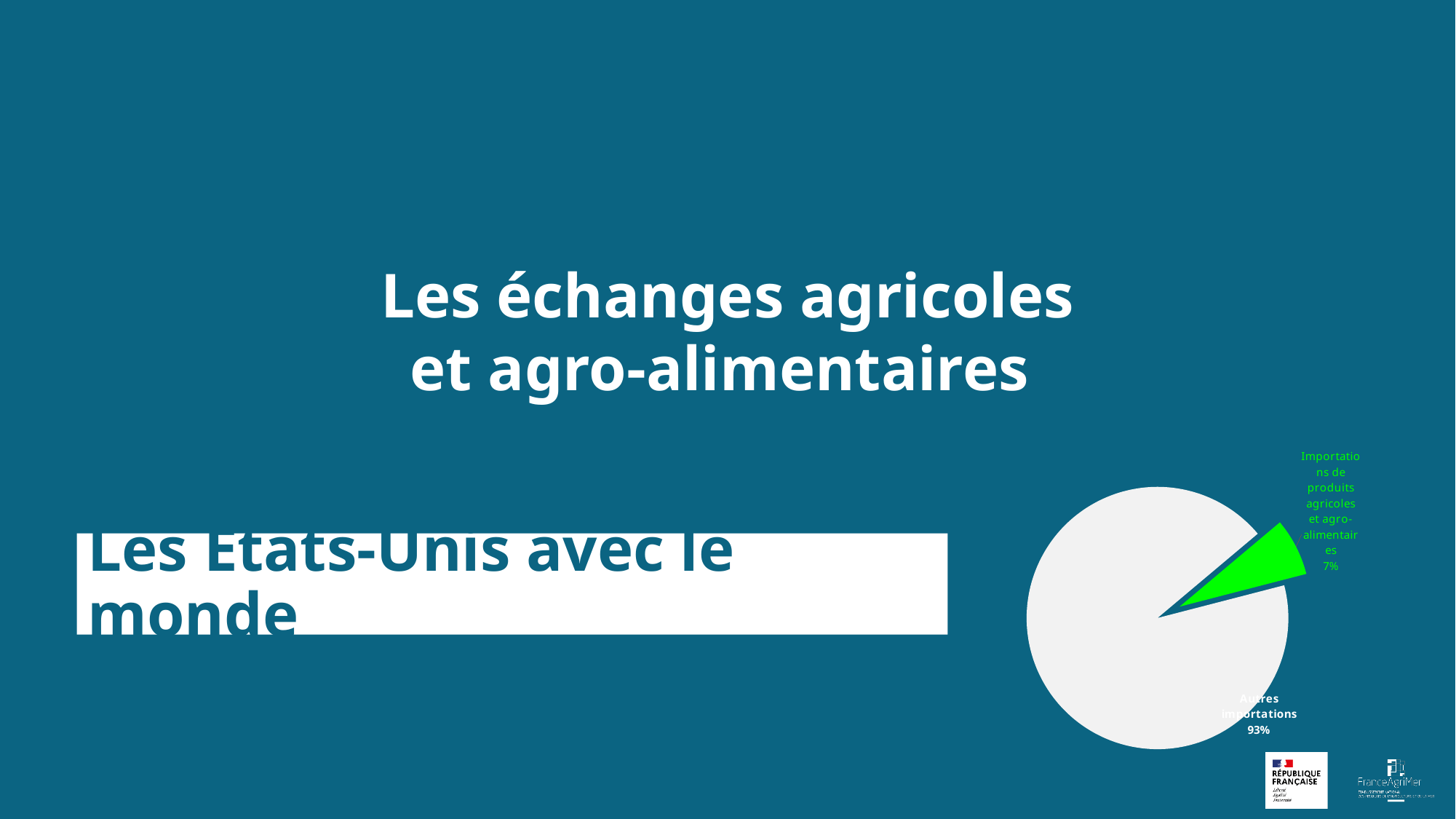
What colour is the "Importations de produits agricoles et agro-alimentaires" slice? green Which slice of the pie chart is the smallest? Importations de produits agricoles et agro-alimentaires What kind of chart is shown on the slide? pie chart How many slices does the pie chart have? 2 What colour is the "Autres importations" slice? light grey What share of the pie is labelled "Autres importations"? 93% Which is larger: the "Autres importations" slice or the "Importations de produits agricoles et agro-alimentaires" slice? Autres importations What is the difference in percentage points between the "Autres importations" slice and the "Importations de produits agricoles et agro-alimentaires" slice? 86 What share of the pie is labelled "Importations de produits agricoles et agro-alimentaires"? 7% Which slice of the pie chart is the largest? Autres importations